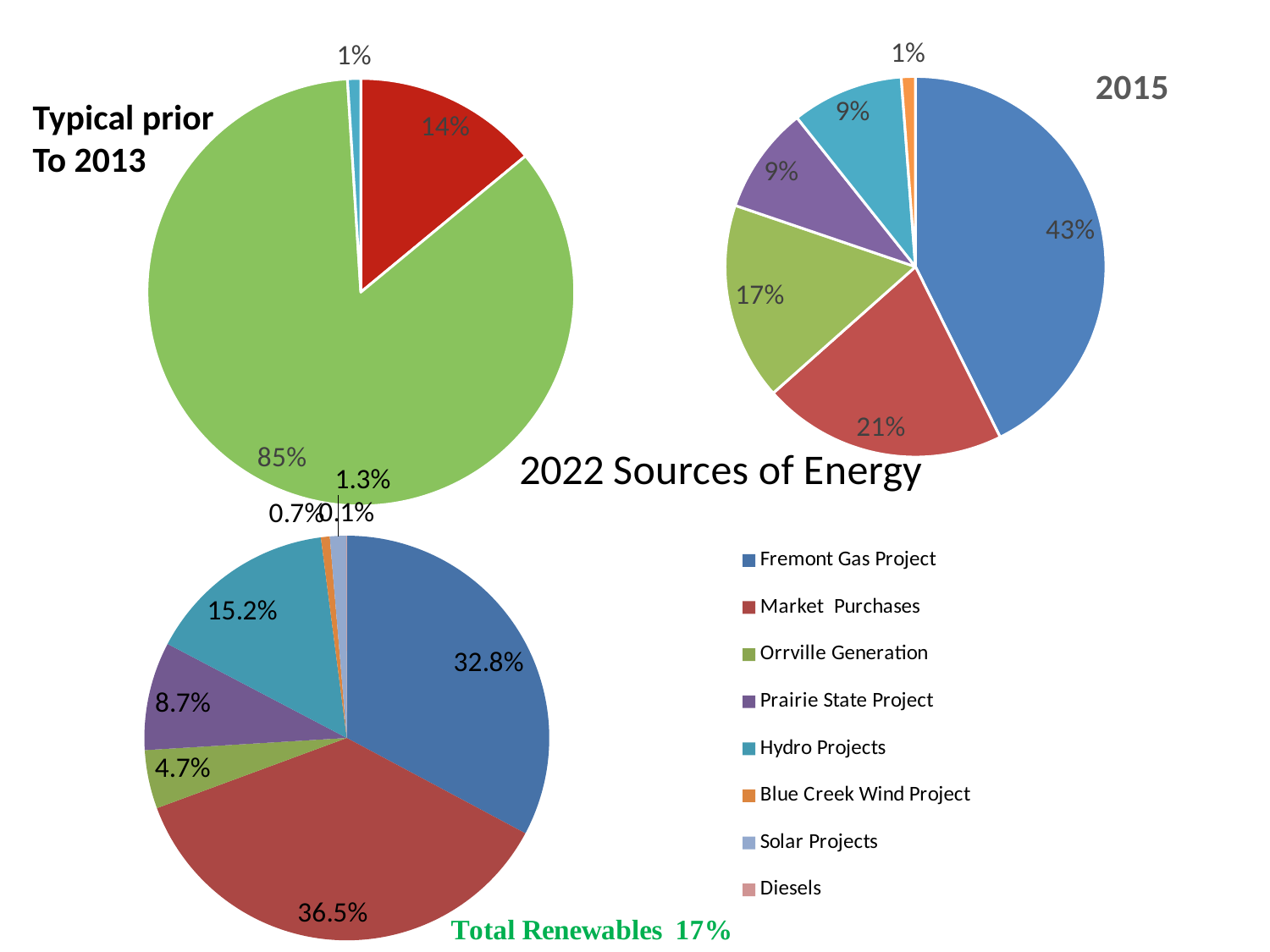
In the "2022 Sources of Energy" chart, how much larger is the Market Purchases share than the Fremont Gas Project share? 3.7% What kind of chart is the "2022 Sources of Energy" chart? pie chart In the "2022 Sources of Energy" chart, what share is Market Purchases? 36.5% In the "2022 Sources of Energy" chart, what share is the Fremont Gas Project? 32.8% In the "2022 Sources of Energy" chart, which is larger: Prairie State Project or Orrville Generation? Prairie State Project In the "2022 Sources of Energy" chart, what share is Hydro Projects? 15.2% In the "2022 Sources of Energy" chart, which source has the largest slice? Market Purchases How many entries does the legend on the slide list? 8 In the "Typical prior To 2013" chart, what share does the largest slice have? 85%